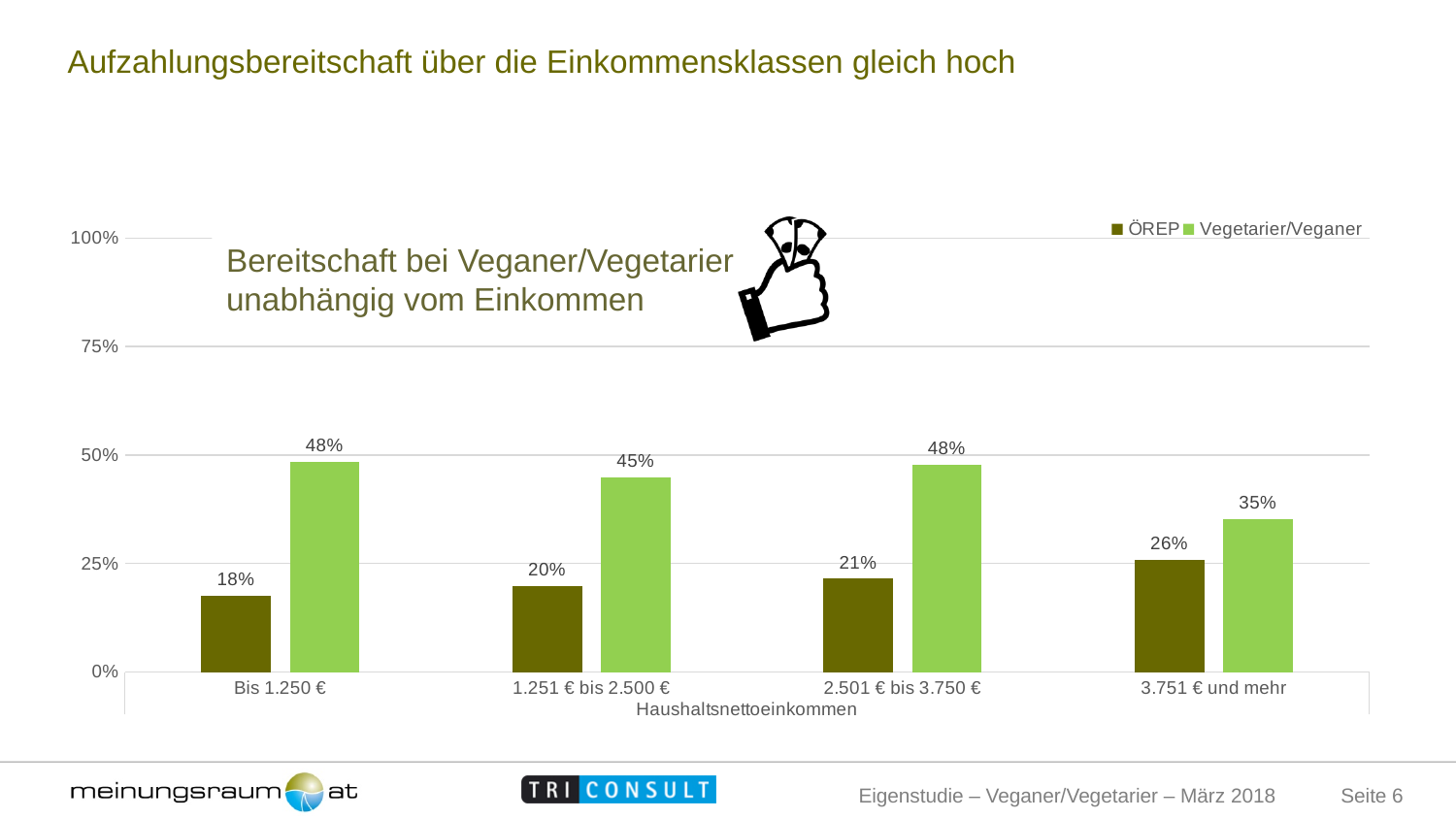
What is the label of the x axis? Haushaltsnettoeinkommen Which is larger in the '3.751 € und mehr' income class: the ÖREP value or the Vegetarier/Veganer value? Vegetarier/Veganer What is the value for ÖREP in the 'Bis 1.250 €' income class? 18% What is the value for Vegetarier/Veganer in the '2.501 € bis 3.750 €' income class? 48% Which income class has the lowest value for the Vegetarier/Veganer series? 3.751 € und mehr How many series does the legend list? 2 Which income class has the highest value for the ÖREP series? 3.751 € und mehr What is the value for Vegetarier/Veganer in the '1.251 € bis 2.500 €' income class? 45% What is the difference between the Vegetarier/Veganer and ÖREP values in the 'Bis 1.250 €' income class? 30 percentage points How many income classes are shown on the x axis? 4 What is the value for ÖREP in the '3.751 € und mehr' income class? 26% What kind of chart is shown on the slide? Bar chart